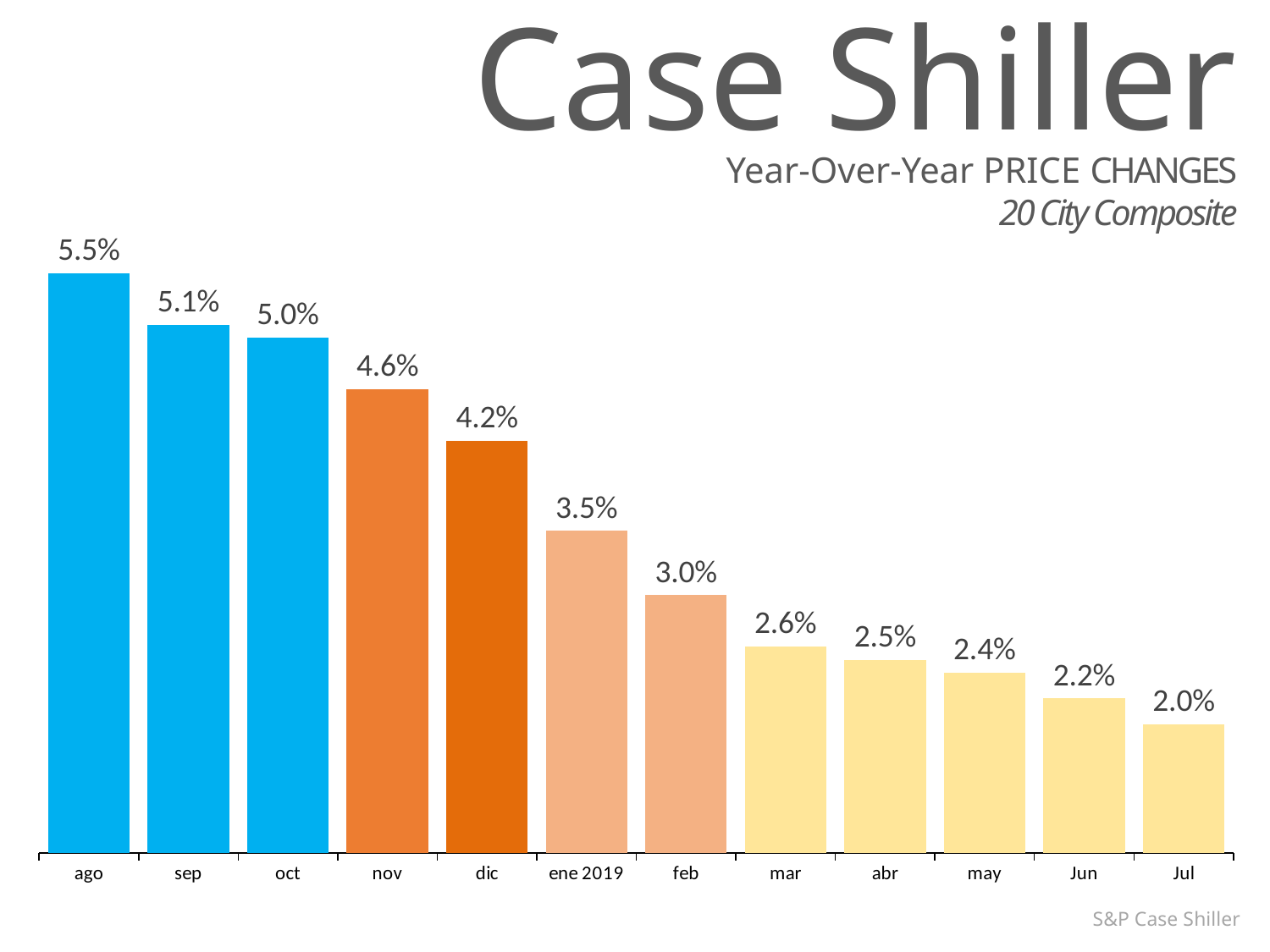
Which month has the highest value on the chart? ago What kind of chart is shown on the slide? bar chart What is the difference between the values for nov and dic? 0.4% Do the values rise or fall from ago to Jul along the x axis? fall What is the source cited at the bottom right of the chart? S&P Case Shiller Which month has the lowest value on the chart? Jul What is the value shown for ene 2019? 3.5% What is the year-over-year price change shown for ago? 5.5% Which is larger, the value for feb or the value for mar? feb What is the value shown for Jul? 2.0% How many months are shown on the x axis? 12 What is the difference between the values for ago and Jul? 3.5%